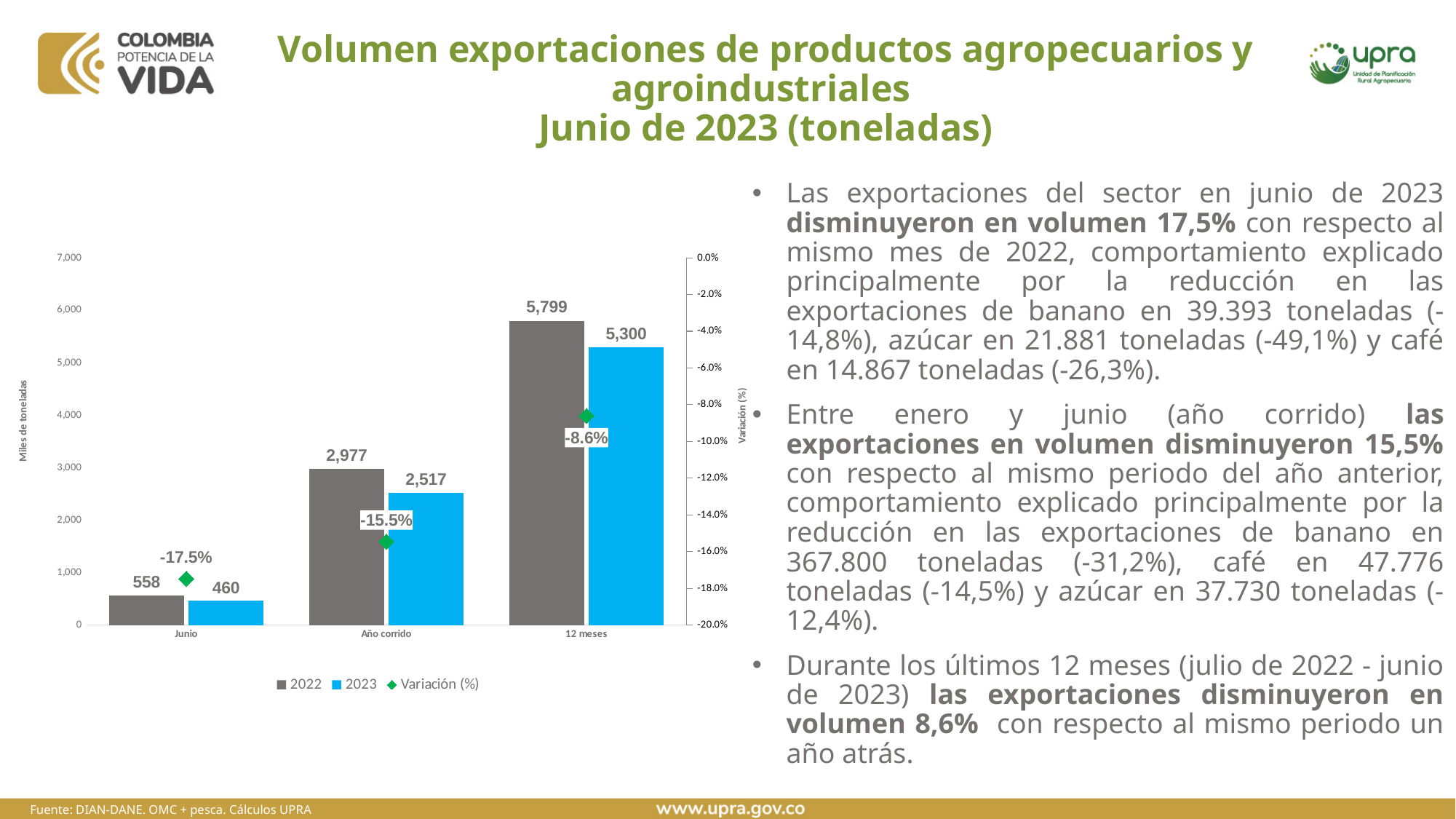
What is the difference between the 2022 and 2023 values for 12 meses? 499 Which category has the highest 2023 value? 12 meses Which category has the lowest 2022 value? Junio Is the 2023 value for 12 meses greater or less than 5,000? greater How many series does the legend list? 3 What is the label of the left vertical axis? Miles de toneladas What is the Variación (%) value for 12 meses? -8.6% Which is larger for Año corrido, the 2022 value or the 2023 value? 2022 What is the 2023 value for Año corrido? 2,517 What kind of chart is used for the 2022 and 2023 series? bar chart What is the 2022 value for Junio? 558 How many categories are shown on the x axis? 3